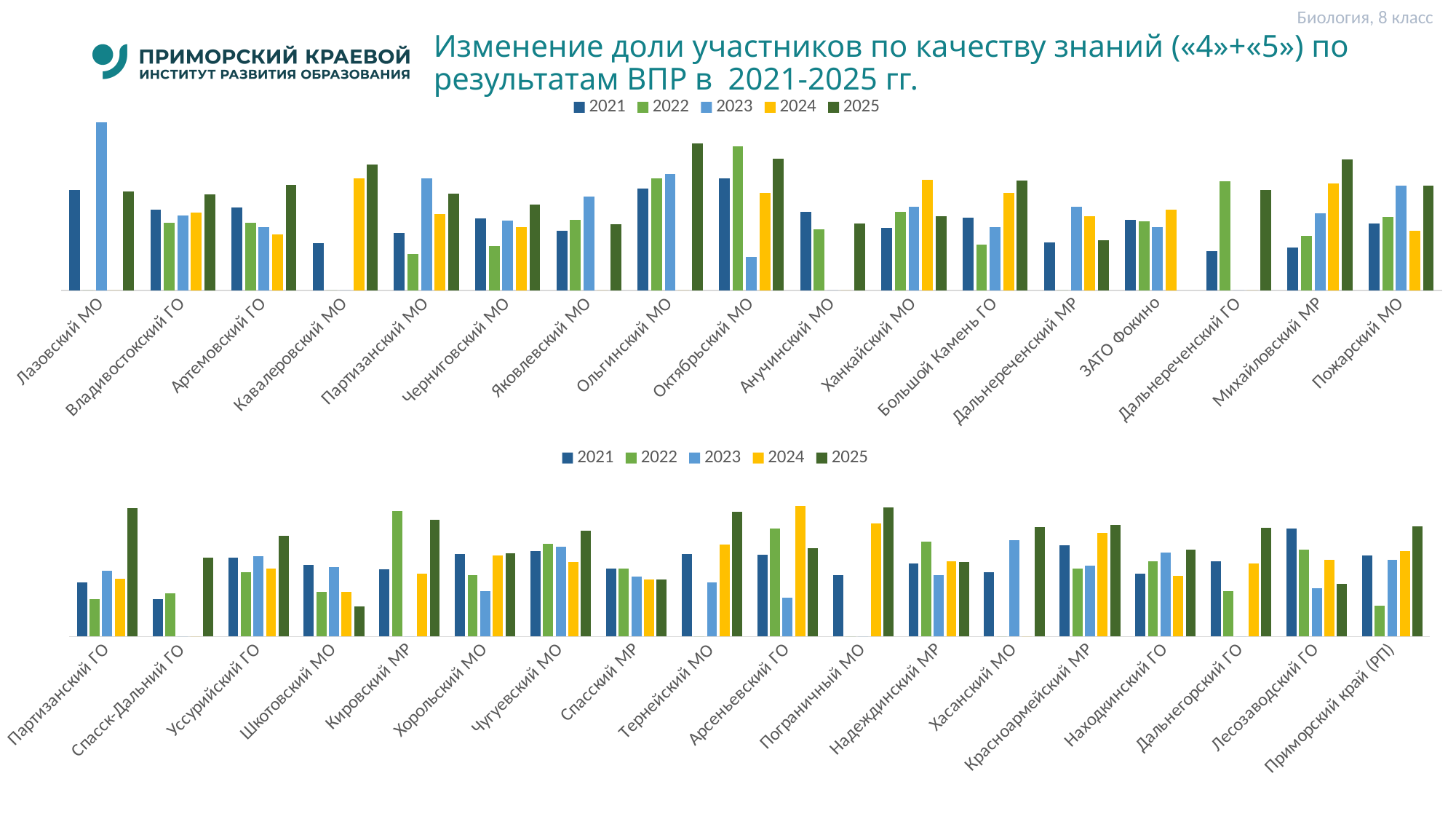
What kind of chart is used on this slide? bar chart In the top chart, which year has the highest bar for Ольгинский МО? 2025 In the bottom chart, which year has the highest bar for Партизанский ГО? 2025 How many series does the legend of the top chart list? 5 In the top chart, which year has the lowest bar for Октябрьский МО? 2023 In the top chart, which is larger for Ханкайский МО: the 2021 value or the 2024 value? 2024 How many municipalities (categories) are shown on the bottom chart? 18 In the top chart, which year has the highest bar for Лазовский МО? 2023 Which years are listed in the legend of the charts? 2021, 2022, 2023, 2024, 2025 How many municipalities (categories) are shown on the top chart? 17